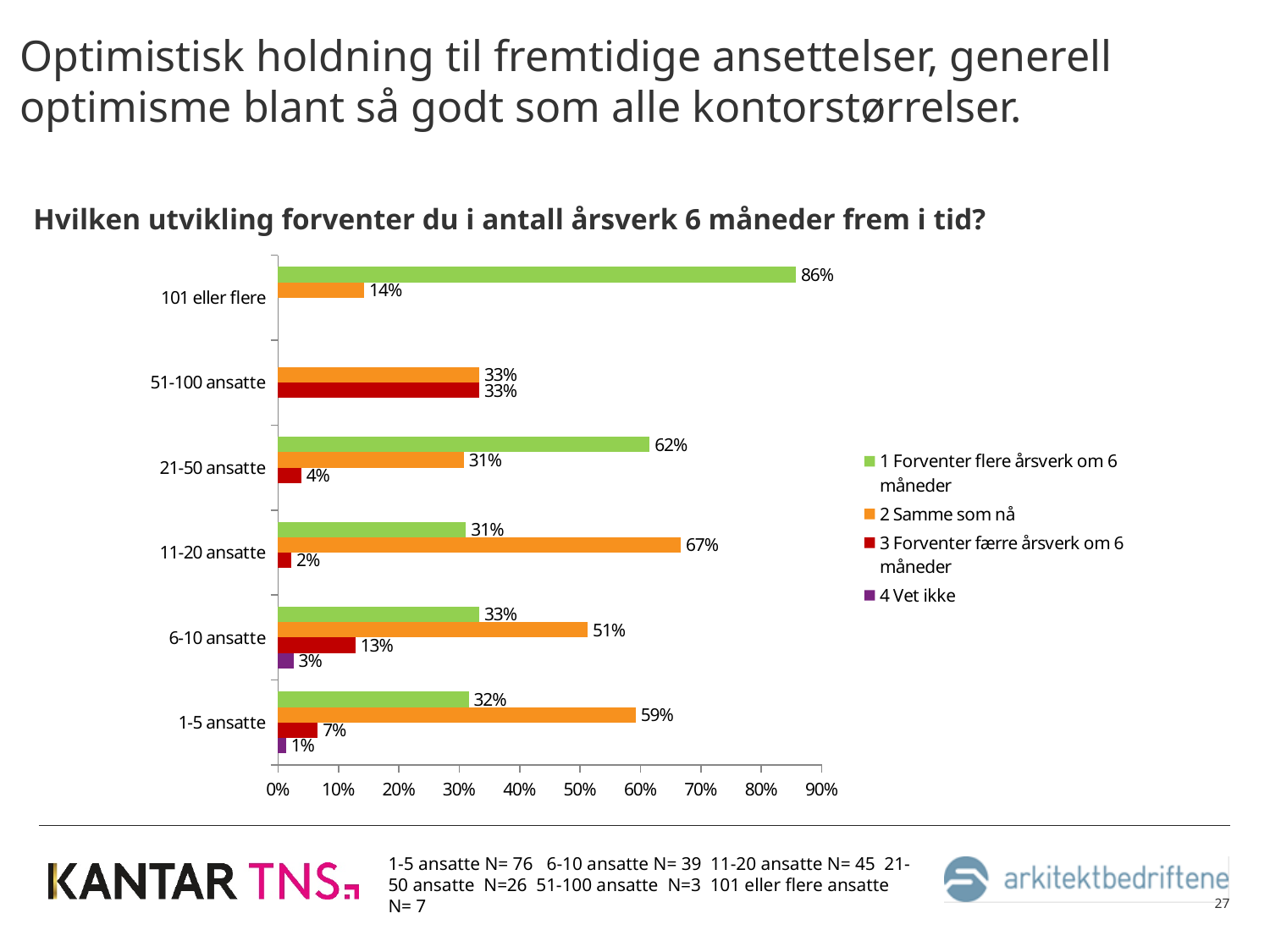
For 21-50 ansatte, which is larger: '1 Forventer flere årsverk om 6 måneder' or '2 Samme som nå'? 1 Forventer flere årsverk om 6 måneder What type of chart is shown on the slide? Bar chart How many office size categories are shown on the chart? 6 What is the difference between the '2 Samme som nå' value and the '1 Forventer flere årsverk om 6 måneder' value for 1-5 ansatte? 27% Is the '2 Samme som nå' value for 6-10 ansatte greater or less than 50%? greater How many series does the legend list? 4 Which office size category has the highest value for '1 Forventer flere årsverk om 6 måneder'? 101 eller flere What percentage of offices with 101 eller flere ansatte expect more årsverk in 6 months (series '1 Forventer flere årsverk om 6 måneder')? 86% What is the value of '3 Forventer færre årsverk om 6 måneder' for 6-10 ansatte? 13% What is the value of '4 Vet ikke' for 1-5 ansatte? 1% Which office size category has the lowest value for '2 Samme som nå'? 101 eller flere What is the value of '2 Samme som nå' for 11-20 ansatte? 67%